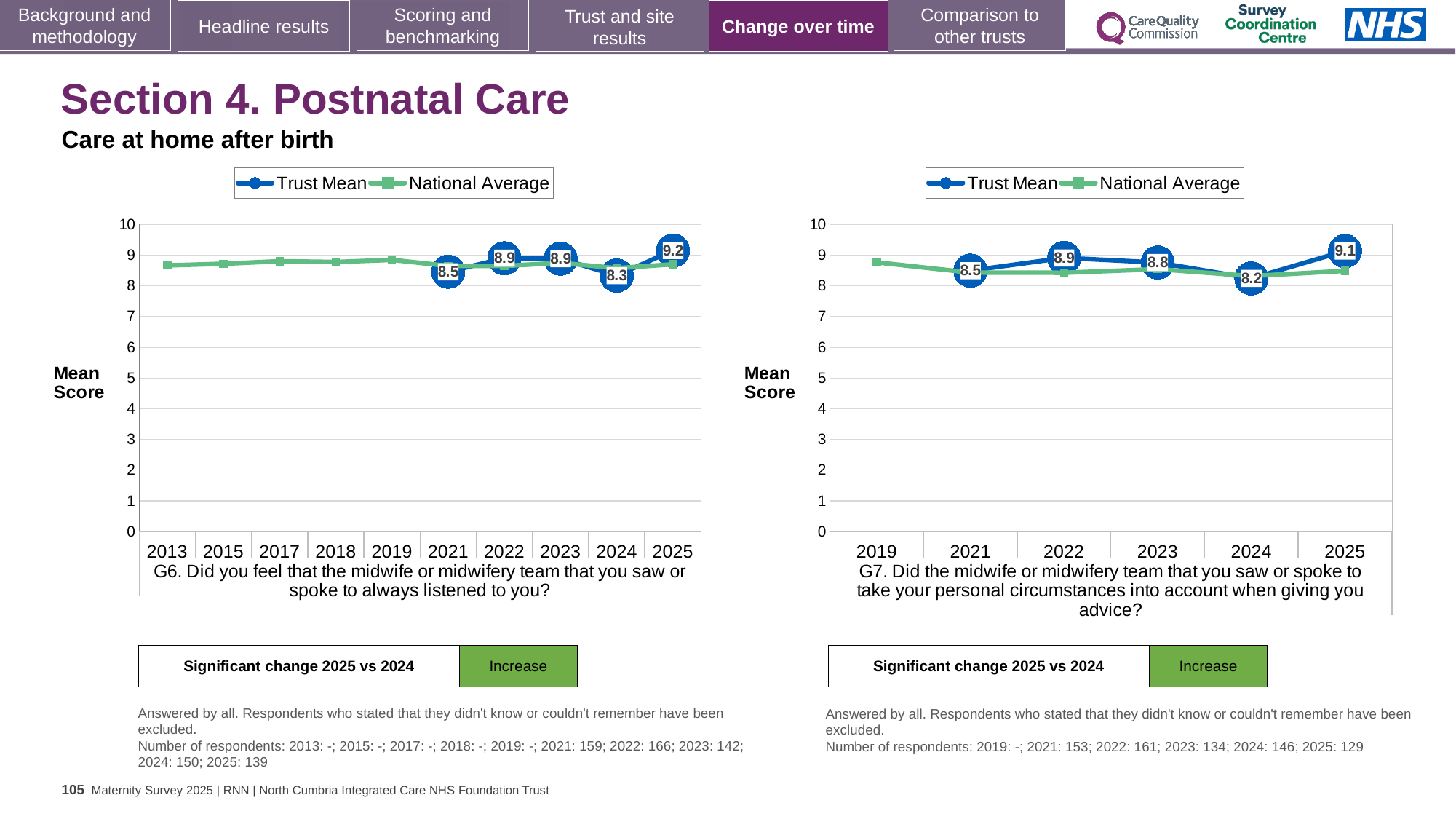
In the G6 chart (left), which year has the highest Trust Mean score? 2025 In the G7 chart (right), did the Trust Mean rise or fall from 2024 to 2025? Rise How many years are shown on the x axis of the G7 chart (right)? 6 In the G7 chart (right), what is the Trust Mean score for 2023? 8.8 In the G6 chart (left), is the Trust Mean score higher in 2022 or in 2024? 2022 How many series does the legend of the G6 chart (left) list? 2 What type of chart is the G7 chart (right)? Line chart In the G7 chart (right), what is the difference between the Trust Mean scores for 2025 and 2024? 0.9 In the G6 chart (left), what is the Trust Mean score for 2024? 8.3 In the G6 chart (left), what is the Trust Mean score for 2025? 9.2 In the G7 chart (right), which year has the lowest Trust Mean score? 2024 In the G6 chart (left), is the National Average for 2013 greater or less than 8? greater